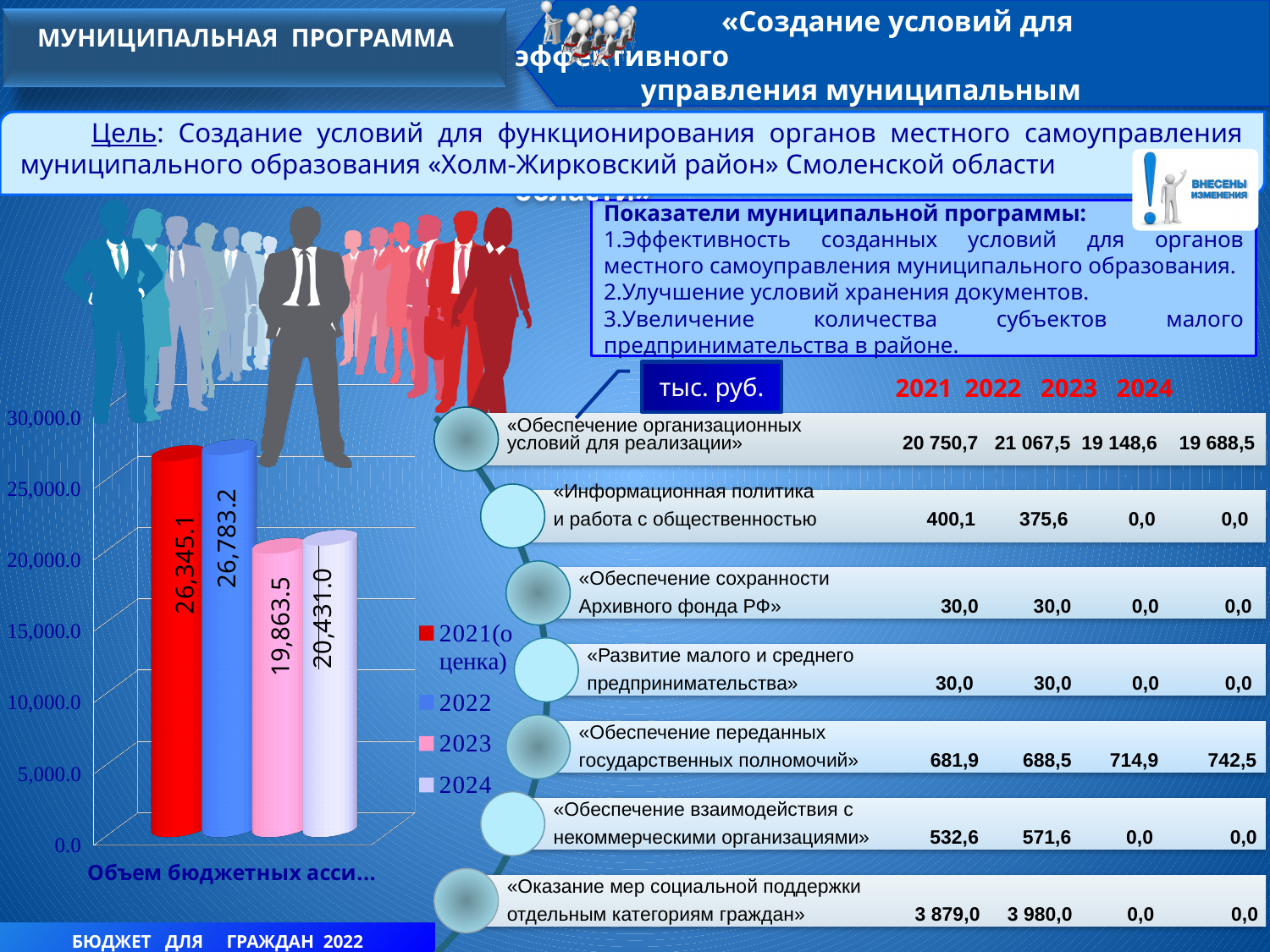
Which year has the highest bar? 2022 What is the value of the bar for 2021(оценка)? 26,345.1 What is the value of the bar for 2022? 26,783.2 Which year has the lowest bar? 2023 How many bars are plotted in the chart? 4 What is the value of the bar for 2024? 20,431.0 What is the difference between the 2022 value and the 2023 value? 6,919.7 Which is larger, the value for 2024 or the value for 2023? 2024 What is the value of the bar for 2023? 19,863.5 Is the value for 2021(оценка) greater or less than 25,000.0? greater What type of chart is shown on the slide? bar chart How many entries does the chart legend list? 4